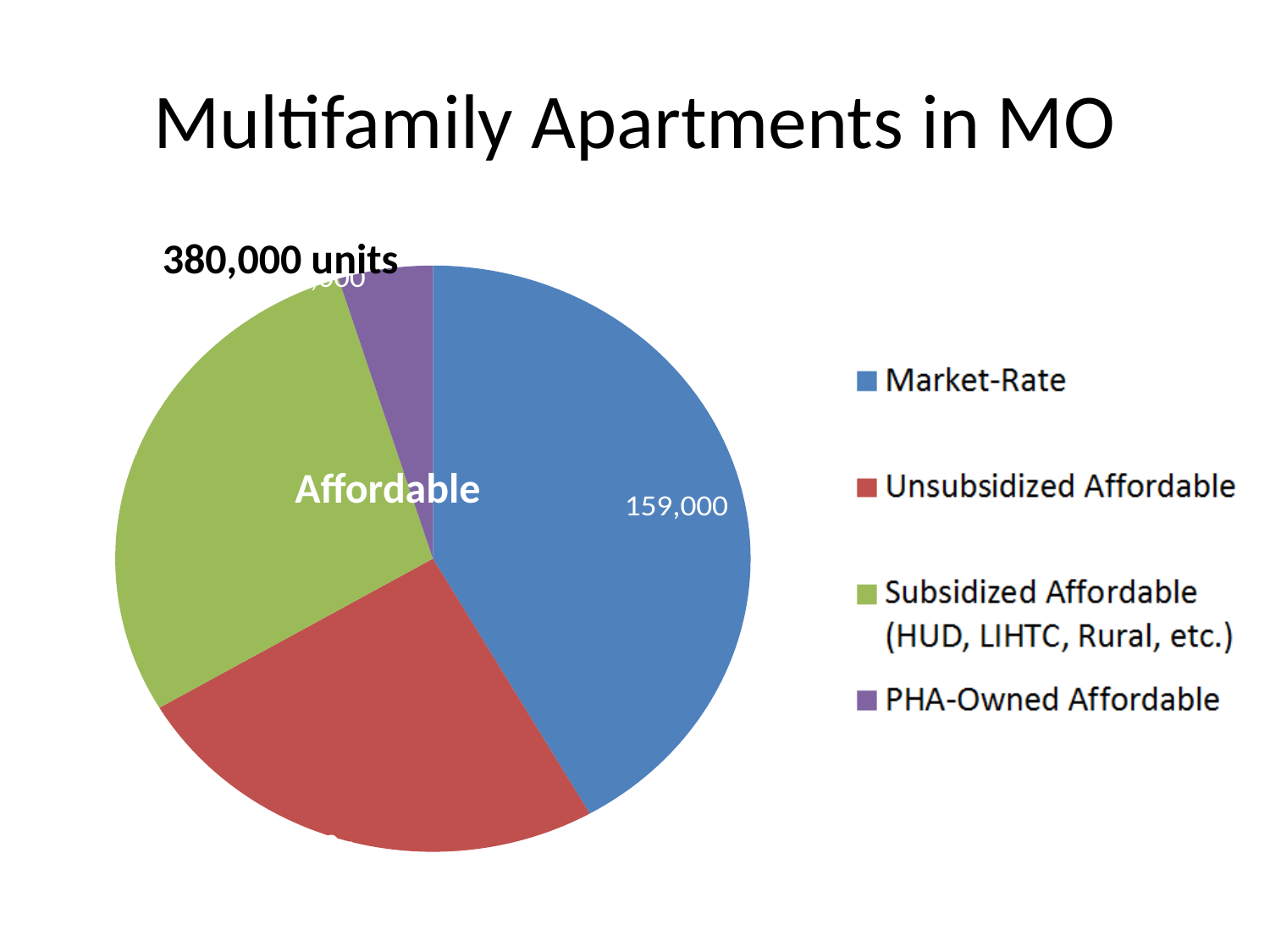
How many entries does the legend list? 4 Which is larger, the Market-Rate slice or the Unsubsidized Affordable slice? Market-Rate Which category has the smallest slice of the pie? PHA-Owned Affordable What kind of chart is shown on the slide? pie chart Which is larger, the Market-Rate slice or the PHA-Owned Affordable slice? Market-Rate What value is labelled on the Market-Rate slice? 159,000 Which category has the largest slice of the pie? Market-Rate What is the title of the slide's chart? Multifamily Apartments in MO How many slices does the pie chart have? 4 What total number of units is stated on the slide? 380,000 units